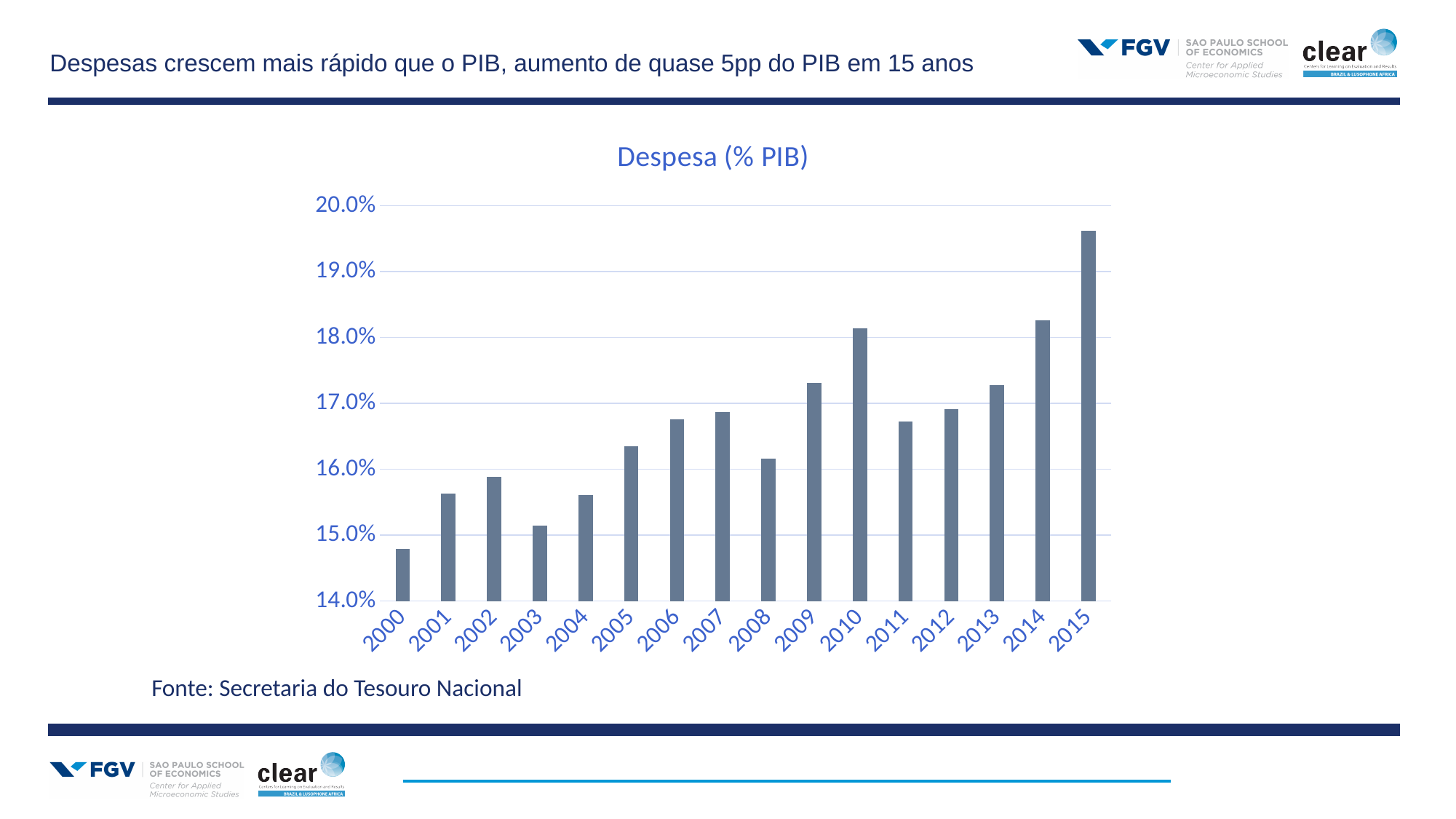
Which year has the larger value, 2002 or 2003? 2002 Which year has the lowest value in the chart? 2000 Is the value for 2008 greater or less than 17.0%? less Which year has the highest value in the chart? 2015 Overall, do the values rise or fall from 2000 to 2015? Rise How many years are plotted on the x axis of the chart? 16 What type of chart is shown on the slide? Bar chart Is the value for 2010 greater or less than 18.0%? greater Which year has the larger value, 2010 or 2011? 2010 Is the value for 2015 greater or less than 19.0%? greater What is the title of the chart? Despesa (% PIB)